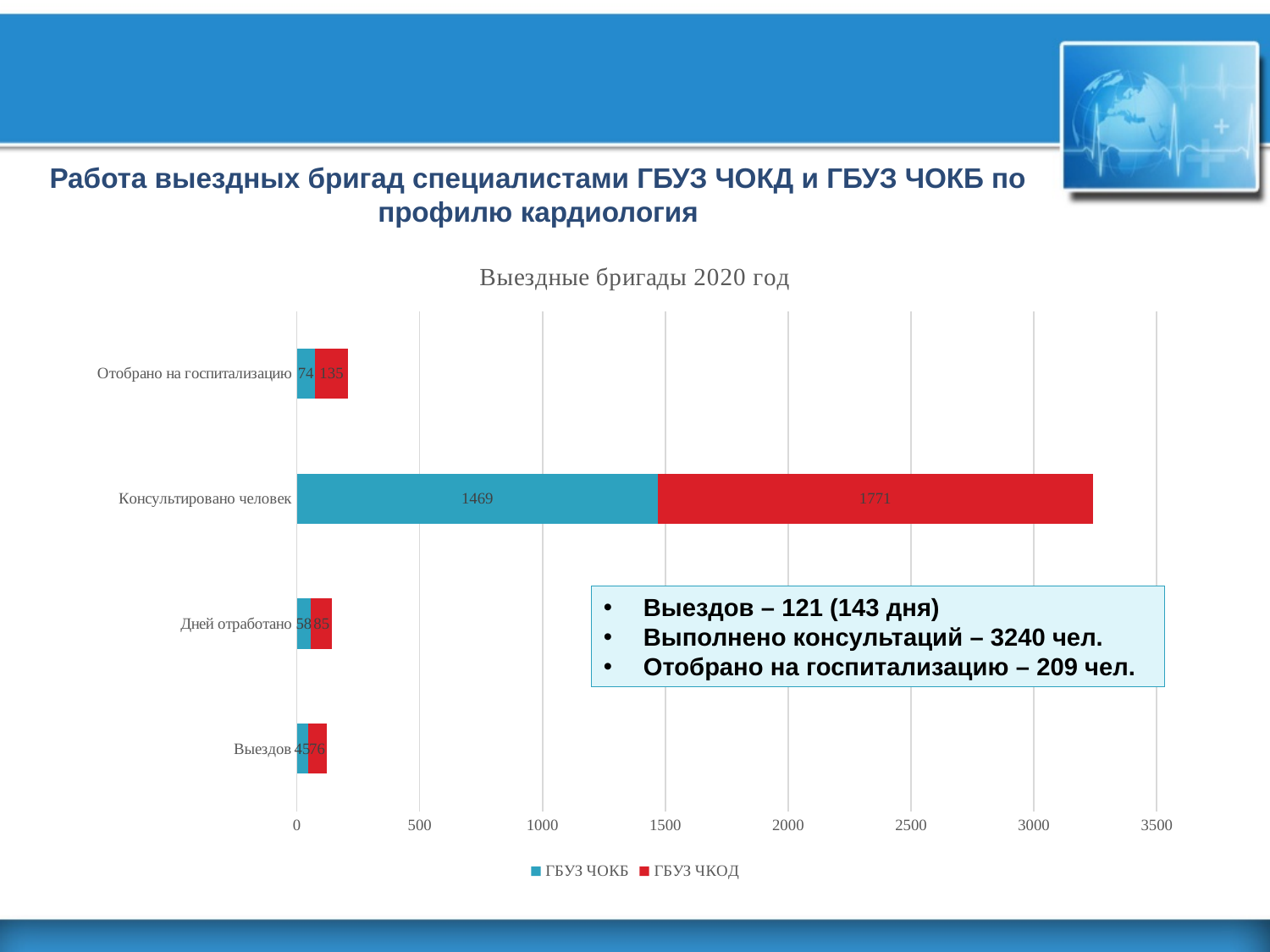
What is the total of the stacked bar for Консультировано человек? 3240 How many series does the legend list? 2 What is the value for ГБУЗ ЧКОД in the category Отобрано на госпитализацию? 135 What is the difference between the ГБУЗ ЧКОД and ГБУЗ ЧОКБ values for Консультировано человек? 302 What is the value for ГБУЗ ЧОКБ in the category Дней отработано? 58 What is the title of the chart? Выездные бригады 2020 год What is the value for ГБУЗ ЧКОД in the category Консультировано человек? 1771 What kind of chart is shown on the slide? Stacked bar chart Which is larger for Отобрано на госпитализацию: ГБУЗ ЧОКБ or ГБУЗ ЧКОД? ГБУЗ ЧКОД Which category has the largest total bar? Консультировано человек What is the value for ГБУЗ ЧОКБ in the category Консультировано человек? 1469 How many categories are shown on the chart? 4